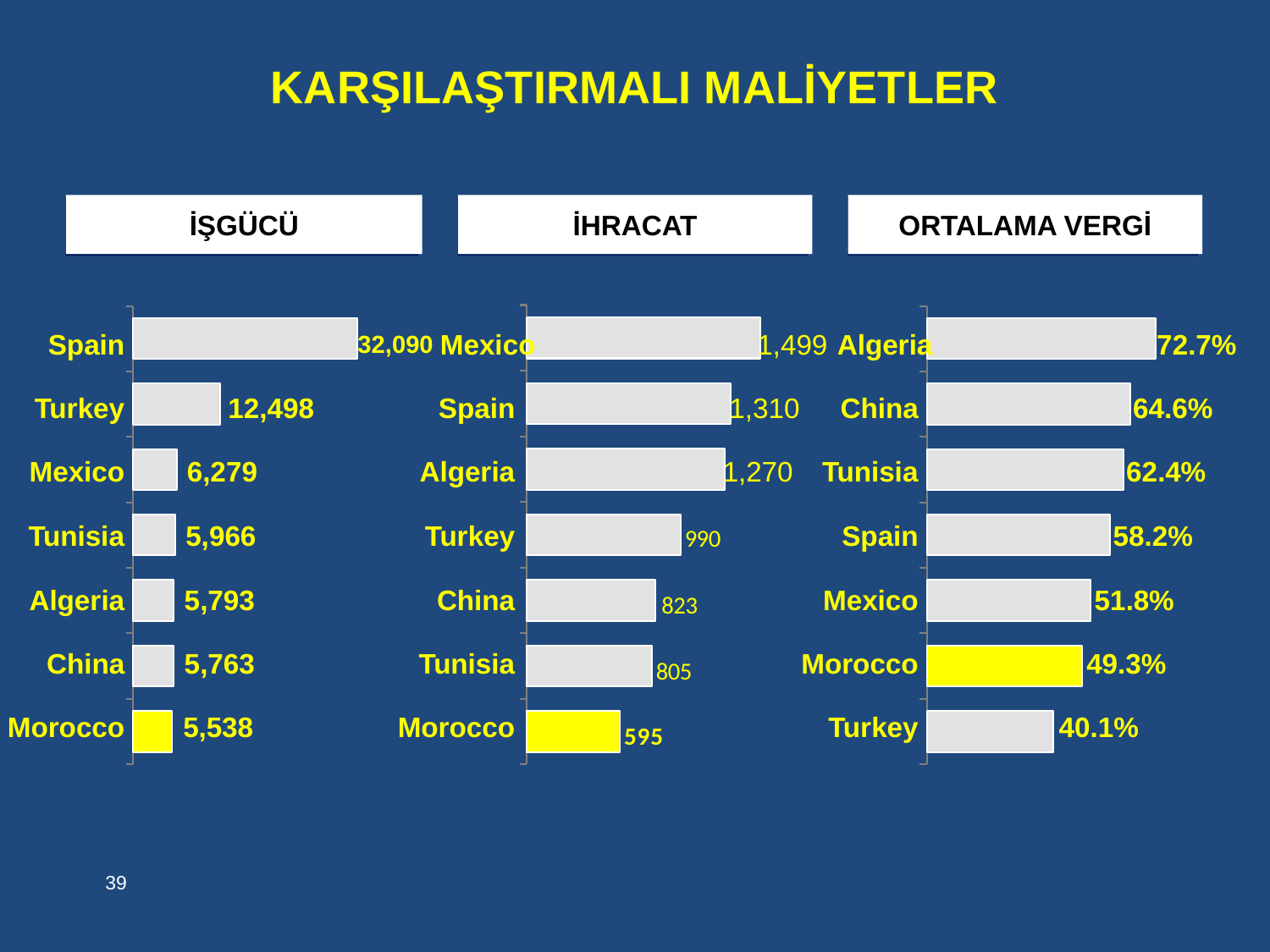
In the İHRACAT chart, what is the difference between Mexico and Spain? 189 In the İŞGÜCÜ chart, what is the difference between Spain and Turkey? 19,592 In the ORTALAMA VERGİ chart, which country has the lowest value? Turkey What type of chart is the İŞGÜCÜ chart? Bar chart In the İŞGÜCÜ chart, which country has the highest value? Spain In the ORTALAMA VERGİ chart, what is the value for Tunisia? 62.4% In the İHRACAT chart, which is larger, Turkey or China? Turkey In the İŞGÜCÜ chart, what is the value for Turkey? 12,498 In the ORTALAMA VERGİ chart, how many countries are shown? 7 In the İHRACAT chart, what is the value for Algeria? 1,270 In the ORTALAMA VERGİ chart, which country's bar is highlighted in yellow? Morocco In the İHRACAT chart, which country has the lowest value? Morocco